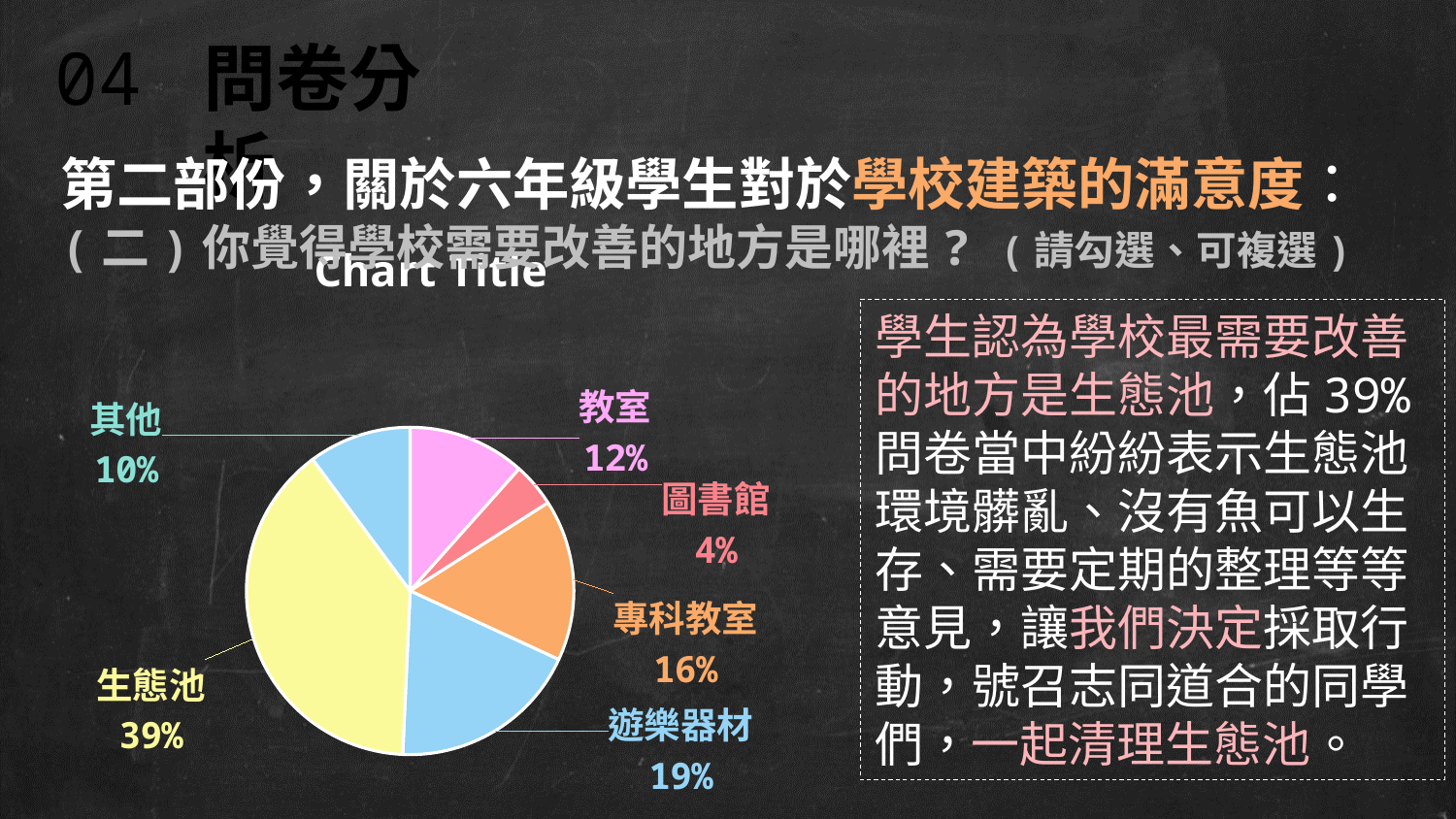
Which is larger, the value for 教室 or the value for 其他? 教室 What is the value shown for 遊樂器材? 19% What is the difference between the values for 生態池 and 遊樂器材? 20% What is the difference between the values for 專科教室 and 教室? 4% What kind of chart is shown on the slide? pie chart How many categories (slices) does the pie chart have? 6 What is the value shown for 圖書館? 4% What is the value shown for 專科教室? 16% What is the title printed above the pie chart? Chart Title Which category has the largest slice of the pie? 生態池 What share of the pie does 生態池 have? 39% Which category has the smallest slice of the pie? 圖書館